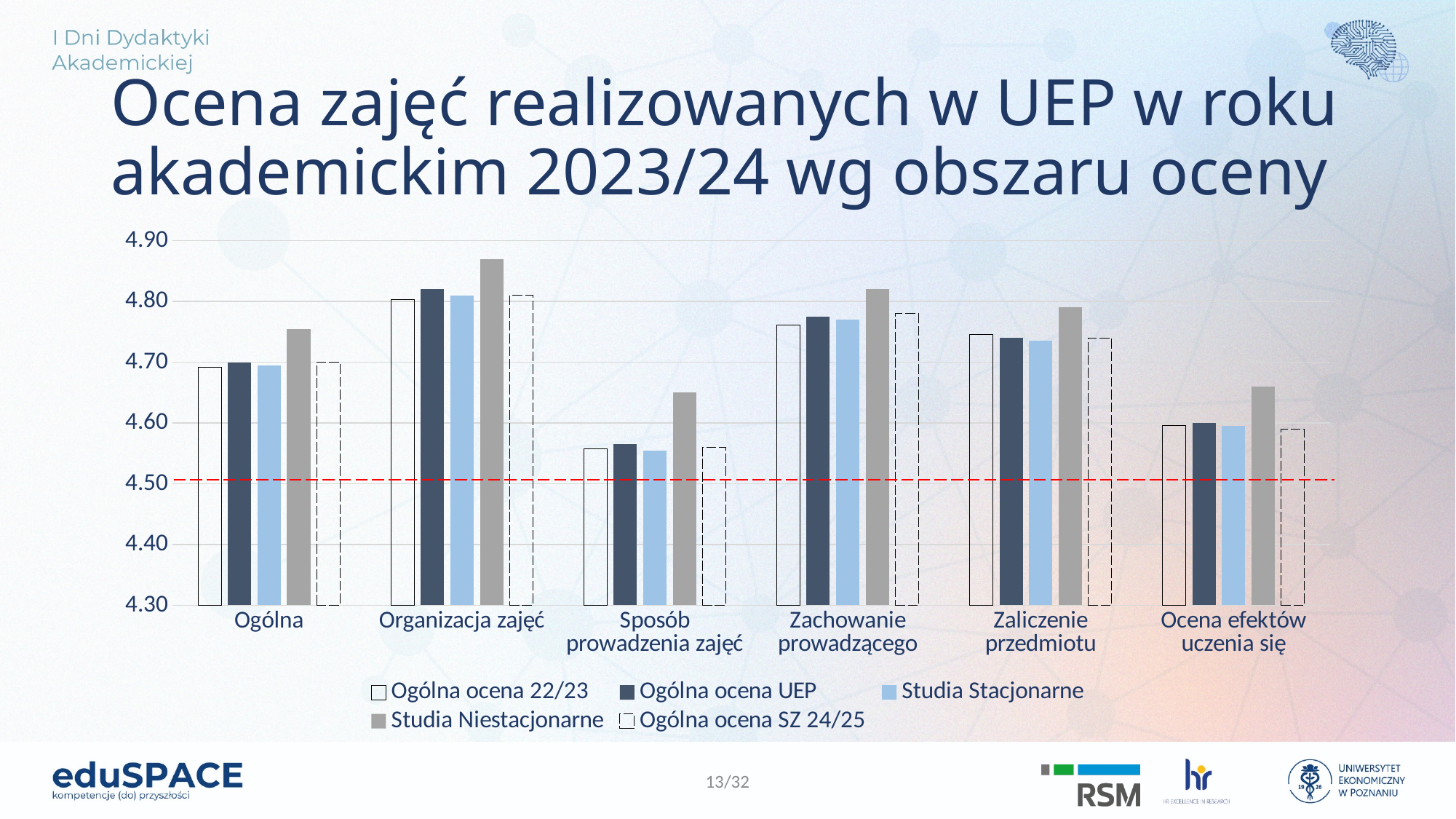
At what value on the y axis is the red dashed horizontal line drawn? 4.50 How many categories are shown on the x axis of the chart? 6 How many series does the chart legend list? 5 Is the 'Ogólna ocena UEP' value for 'Sposób prowadzenia zajęć' greater or less than 4.60? less Which series has the highest value in the 'Organizacja zajęć' category? Studia Niestacjonarne Is the 'Studia Niestacjonarne' value for 'Organizacja zajęć' greater or less than 4.80? greater Which category has the lowest values overall in the chart? Sposób prowadzenia zajęć Which is larger: the 'Studia Niestacjonarne' value for 'Organizacja zajęć' or for 'Ogólna'? Organizacja zajęć Is the 'Studia Niestacjonarne' value for 'Ocena efektów uczenia się' greater or less than 4.60? greater What kind of chart is shown on the slide? bar chart In the 'Sposób prowadzenia zajęć' category, which is larger: 'Studia Stacjonarne' or 'Studia Niestacjonarne'? Studia Niestacjonarne